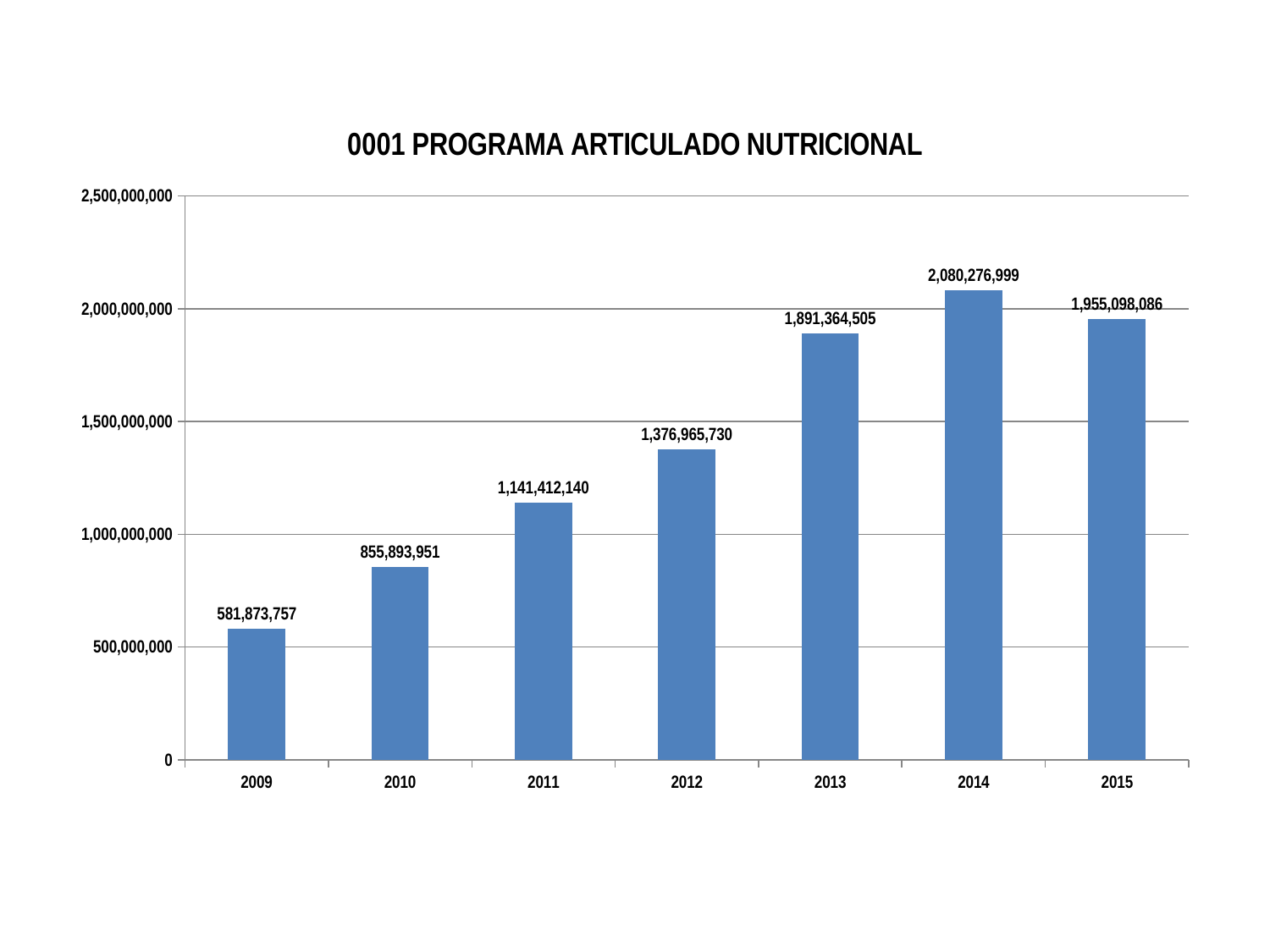
What is the value for 2009? 581,873,757 Which year has the lowest value? 2009 Which year has the highest value? 2014 What is the difference between the values for 2014 and 2015? 125,178,913 What kind of chart is shown? Bar chart How many years are shown on the x axis? 7 What is the difference between the values for 2010 and 2009? 274,020,194 Is the value for 2011 greater or less than 1,000,000,000? greater Which is larger, the value for 2013 or the value for 2015? 2015 What is the value for 2015? 1,955,098,086 What is the value for 2012? 1,376,965,730 What is the title of the chart? 0001 PROGRAMA ARTICULADO NUTRICIONAL